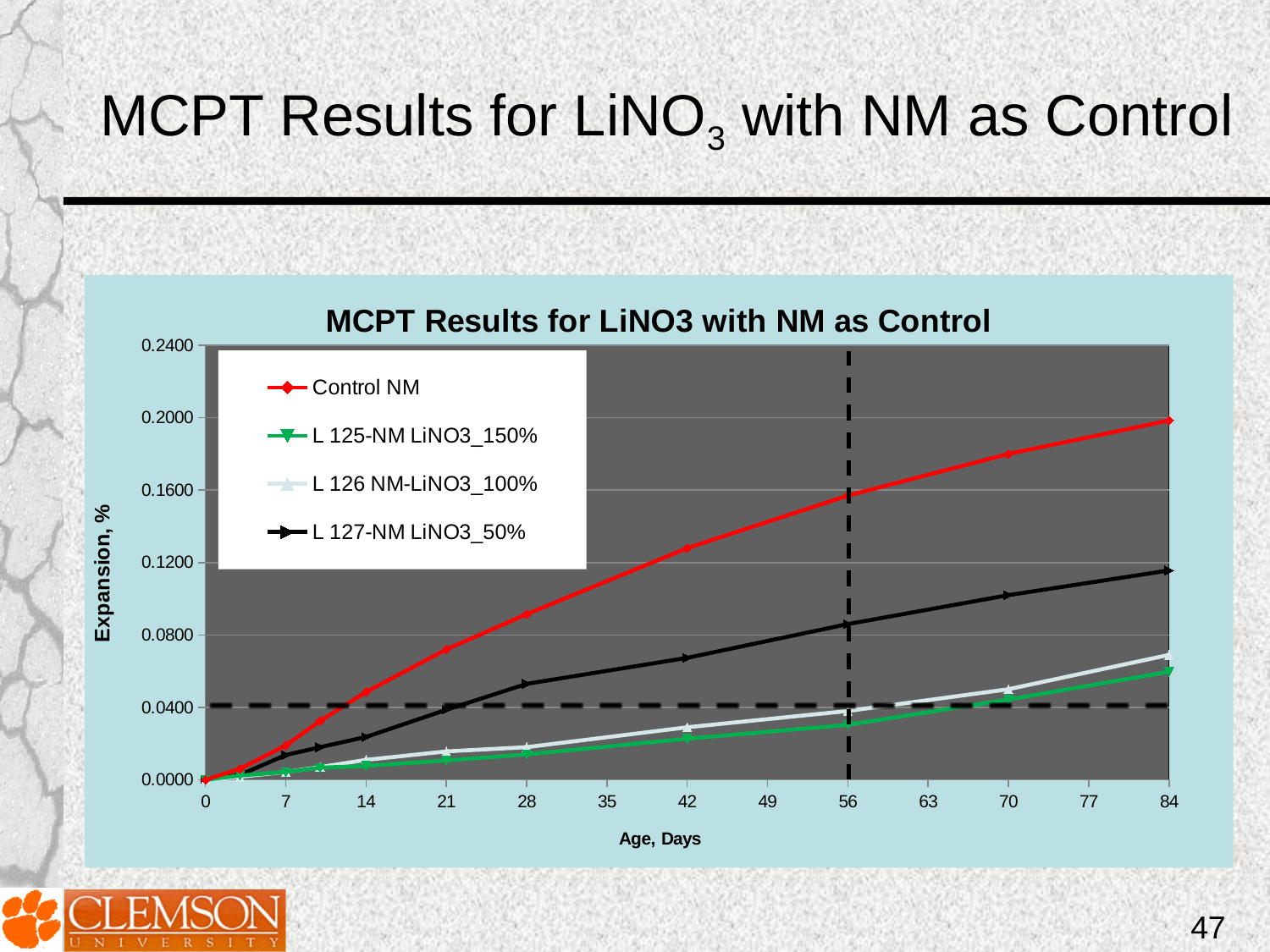
Is the value for L 125-NM LiNO3_150% at 84 days greater or less than 0.0400? greater What is the title of the chart? MCPT Results for LiNO3 with NM as Control Which series has the highest expansion at 84 days? Control NM What is the label of the y axis? Expansion, % How many series does the legend list? 4 At 84 days, which is larger: the value for Control NM or the value for L 127-NM LiNO3_50%? Control NM Which series has the lowest expansion at 84 days? L 125-NM LiNO3_150% Is the value for Control NM at 84 days greater or less than 0.1600? greater Is the value for Control NM at 28 days greater or less than 0.0800? greater Does the Control NM series rise or fall as age increases from 0 to 84 days? rise What kind of chart is shown on the slide? line chart